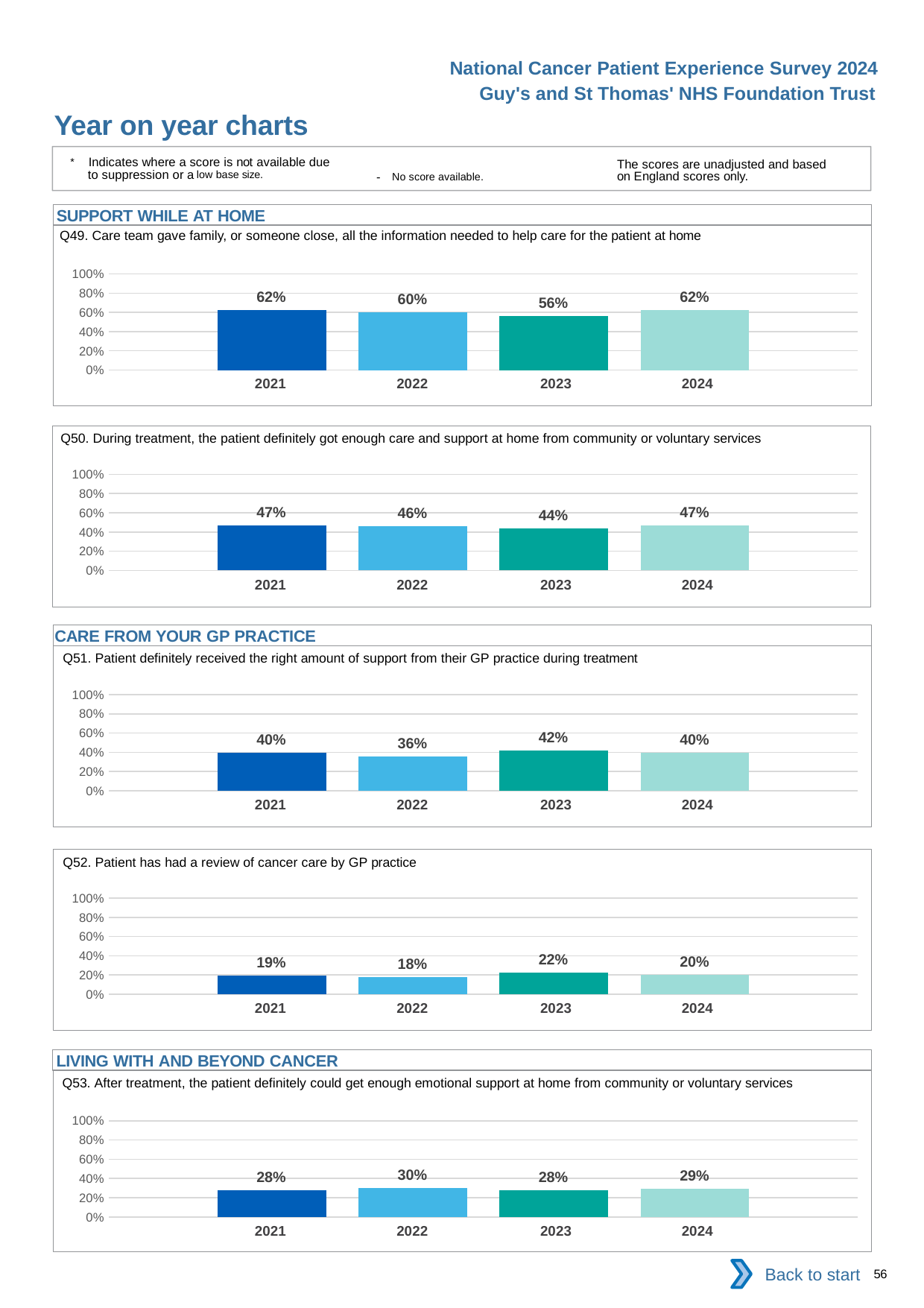
In the Q50 chart, which year has the lowest value? 2023 Which section heading appears above the Q53 chart? LIVING WITH AND BEYOND CANCER In the Q53 chart, what is the value for 2022? 30% In the Q52 chart, is the value for 2021 greater or less than 40%? less In the Q49 chart, what is the difference between the 2021 and 2023 values? 6% In the Q53 chart, which year has the lowest value, 2021 or 2022? 2021 In the Q49 chart, how many years are plotted? 4 In the Q52 chart, what is the difference between the 2023 and 2022 values? 4% What kind of chart is the Q50 chart? bar chart In the Q51 chart, which year has the highest value? 2023 In the Q51 chart, which is larger, the value for 2021 or the value for 2022? 2021 In the Q49 chart, what is the value for 2023? 56%